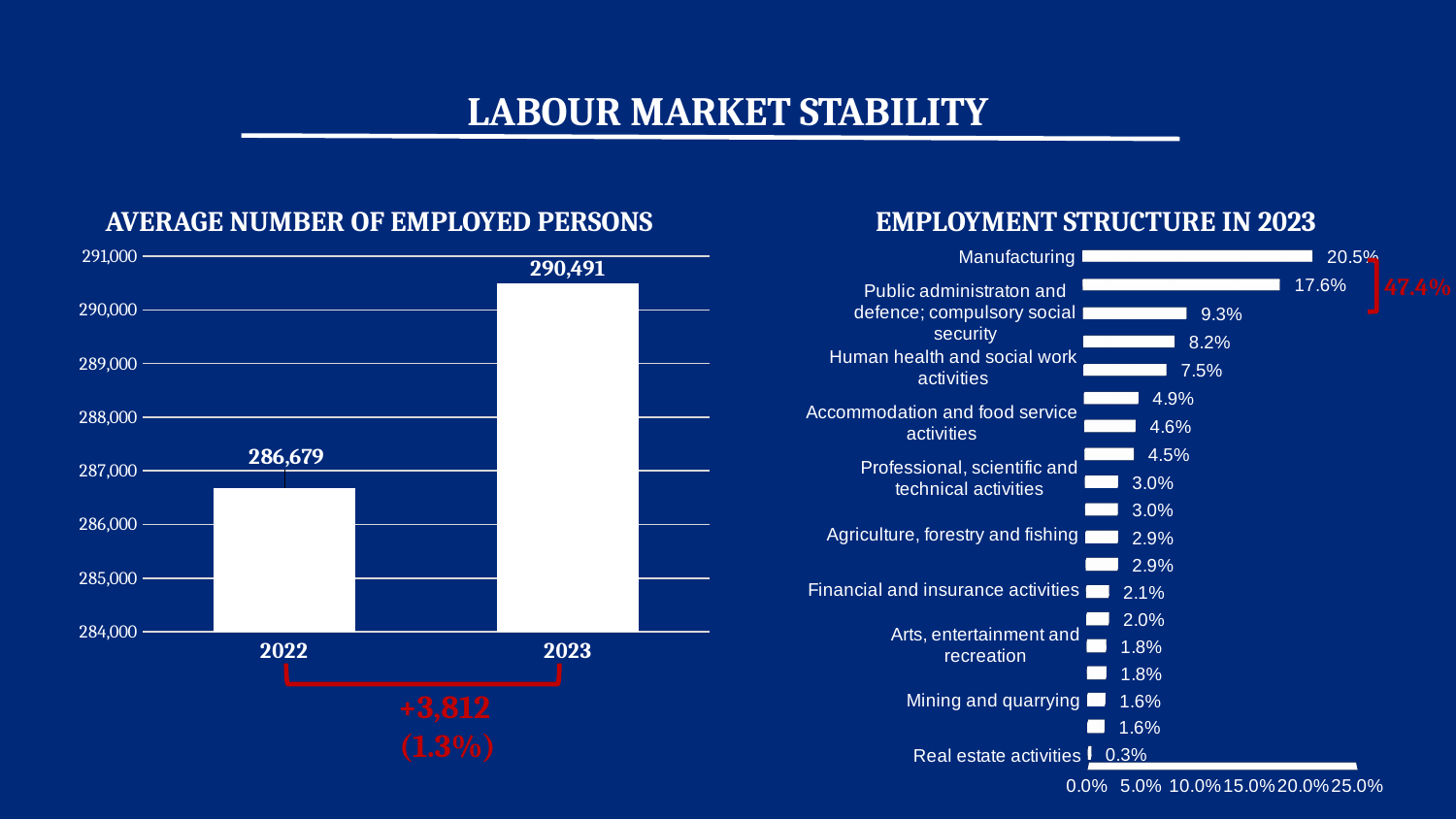
In the 'Employment Structure in 2023' chart, which category has the lowest value? Real estate activities How many bars are shown in the 'Average Number of Employed Persons' chart? 2 In the 'Average Number of Employed Persons' chart, do the values rise or fall from 2022 to 2023? Rise In the 'Average Number of Employed Persons' chart, what percentage change is annotated in red below the bars? 1.3% What kind of chart is the 'Average Number of Employed Persons' chart? Bar chart In the 'Employment Structure in 2023' chart, what is the value for Real estate activities? 0.3% In the 'Employment Structure in 2023' chart, which category has the highest value? Manufacturing In the 'Employment Structure in 2023' chart, what is the value for Manufacturing? 20.5% In the 'Average Number of Employed Persons' chart, which year has the larger value, 2022 or 2023? 2023 In the 'Average Number of Employed Persons' chart, what is the value for 2023? 290,491 In the 'Average Number of Employed Persons' chart, what is the value for 2022? 286,679 In the 'Average Number of Employed Persons' chart, what is the difference between the 2023 and 2022 values? 3,812